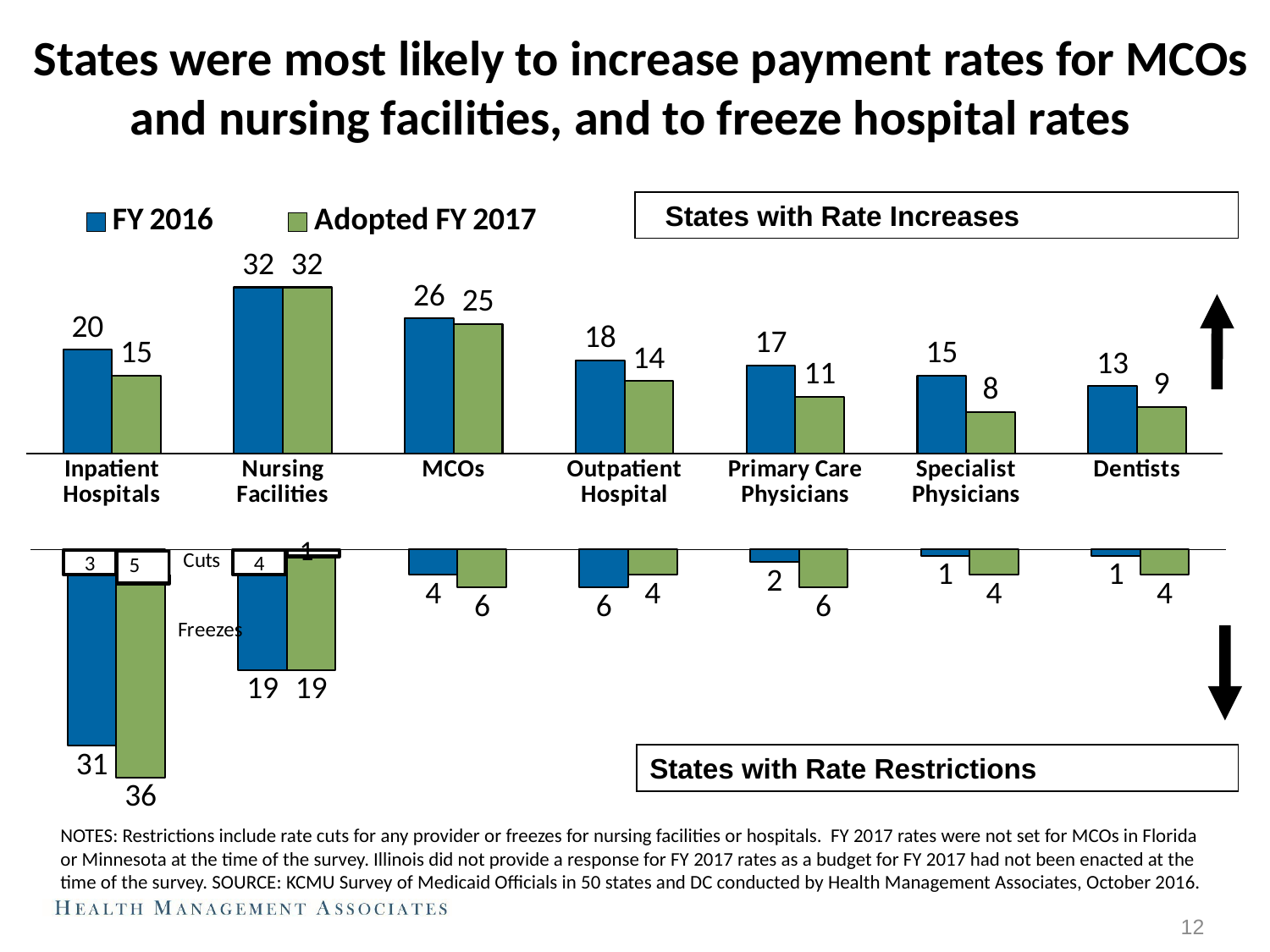
In the States with Rate Increases panel, what is the FY 2016 value for Nursing Facilities? 32 In the States with Rate Restrictions panel, what is the FY 2016 value for Nursing Facilities? 19 In the States with Rate Increases panel, which is larger for Dentists: the FY 2016 value or the Adopted FY 2017 value? FY 2016 In the States with Rate Increases panel, which category has the highest FY 2016 value? Nursing Facilities How many series does the chart legend list? 2 What kind of chart is shown on the slide? Bar chart In the States with Rate Increases panel, which category has the lowest Adopted FY 2017 value? Specialist Physicians In the States with Rate Increases panel, what is the difference between the FY 2016 and Adopted FY 2017 values for Primary Care Physicians? 6 In the States with Rate Increases panel, what is the Adopted FY 2017 value for Specialist Physicians? 8 In the States with Rate Restrictions panel, which is larger for MCOs: the FY 2016 value or the Adopted FY 2017 value? Adopted FY 2017 In the States with Rate Restrictions panel, what is the Adopted FY 2017 value for Inpatient Hospitals? 36 How many provider categories are shown on the x axis of the chart? 7